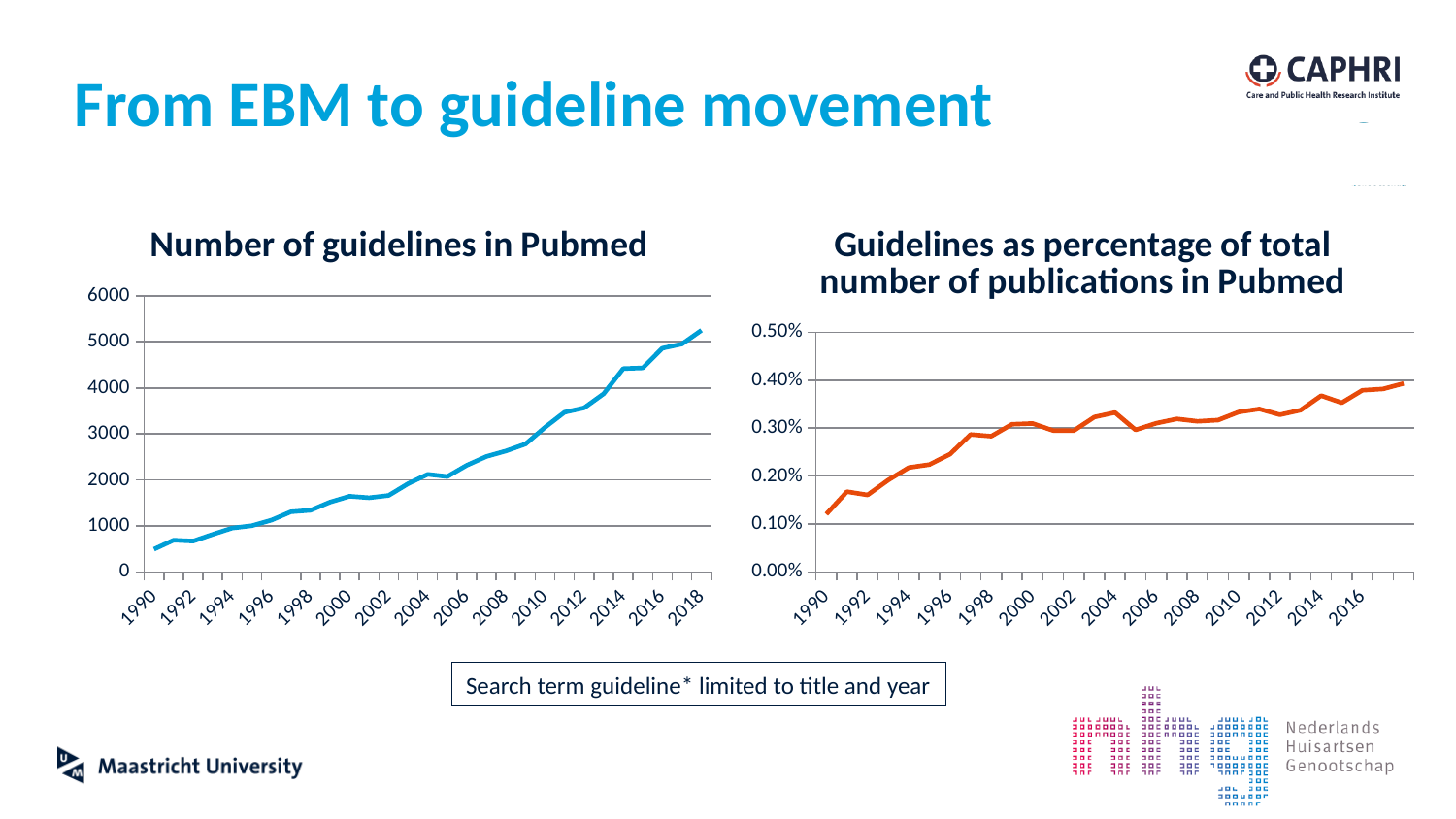
In the 'Number of guidelines in Pubmed' chart, do the values generally rise or fall from 1990 to 2018? rise What colour is the line in the 'Guidelines as percentage of total number of publications in Pubmed' chart? orange In the 'Guidelines as percentage of total number of publications in Pubmed' chart, is the value for 2016 greater or less than 0.30%? greater In the 'Number of guidelines in Pubmed' chart, is the value for 2018 greater or less than 5000? greater In the 'Number of guidelines in Pubmed' chart, which year has the lowest value? 1990 In the 'Number of guidelines in Pubmed' chart, which year has the larger value, 2006 or 2016? 2016 In the 'Guidelines as percentage of total number of publications in Pubmed' chart, is the value for 1992 greater or less than 0.20%? less In the 'Number of guidelines in Pubmed' chart, which year has the highest value? 2018 In the 'Guidelines as percentage of total number of publications in Pubmed' chart, which year has the lowest value? 1990 What kind of chart is the 'Number of guidelines in Pubmed' chart? line chart